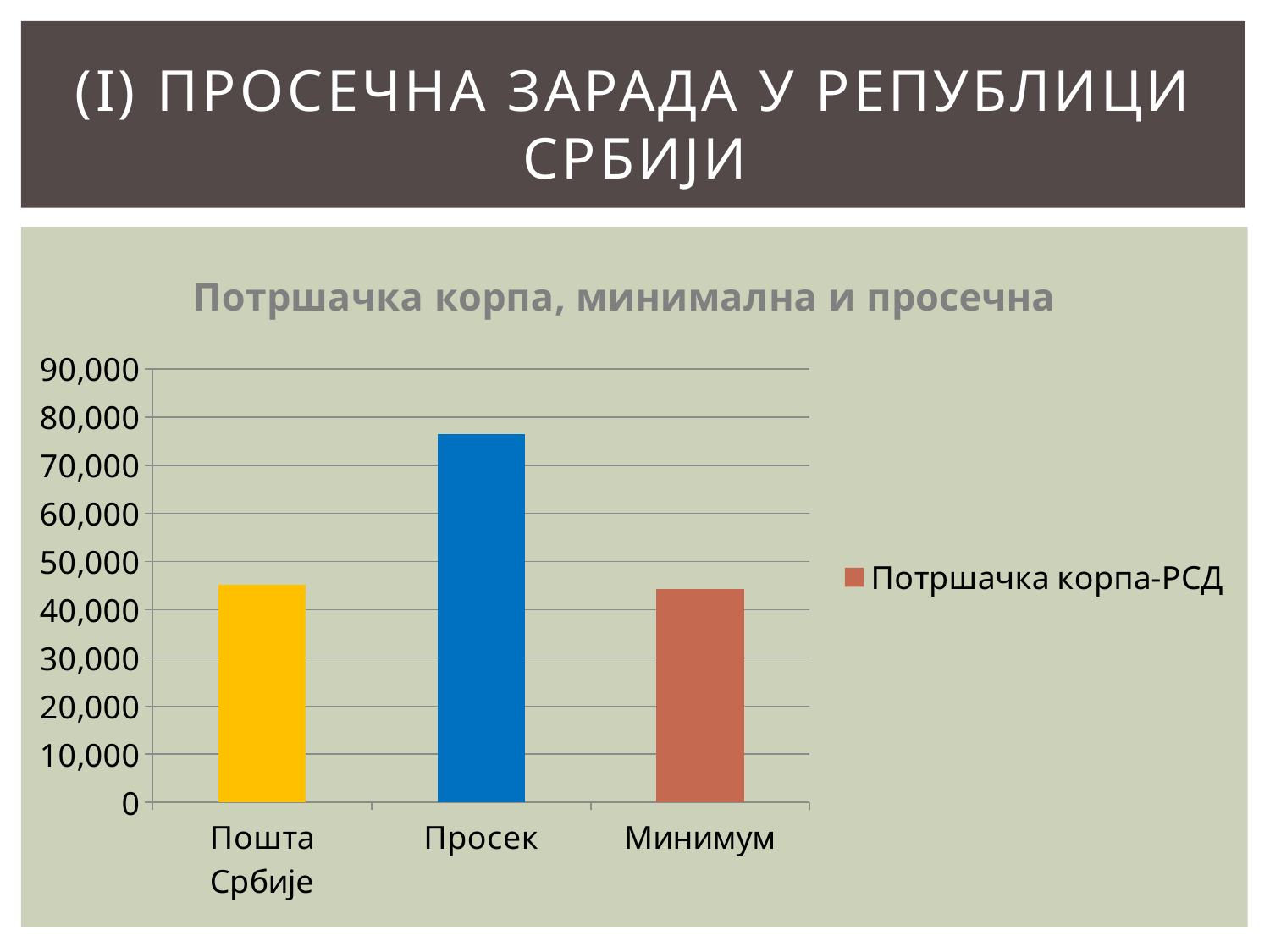
What kind of chart is shown on the slide? bar chart Is the value for Минимум greater or less than 40,000? greater Is the value for Просек greater or less than 70,000? greater How many series does the chart legend list? 1 Which category has the highest bar in the chart? Просек Is the value for Просек greater or less than 80,000? less How many categories are shown on the x axis of the chart? 3 What is the title of the chart? Потршачка корпа, минимална и просечна Which is larger, the value for Просек or the value for Пошта Србије? Просек What series name is shown in the chart legend? Потршачка корпа-РСД Which is larger, the value for Просек or the value for Минимум? Просек